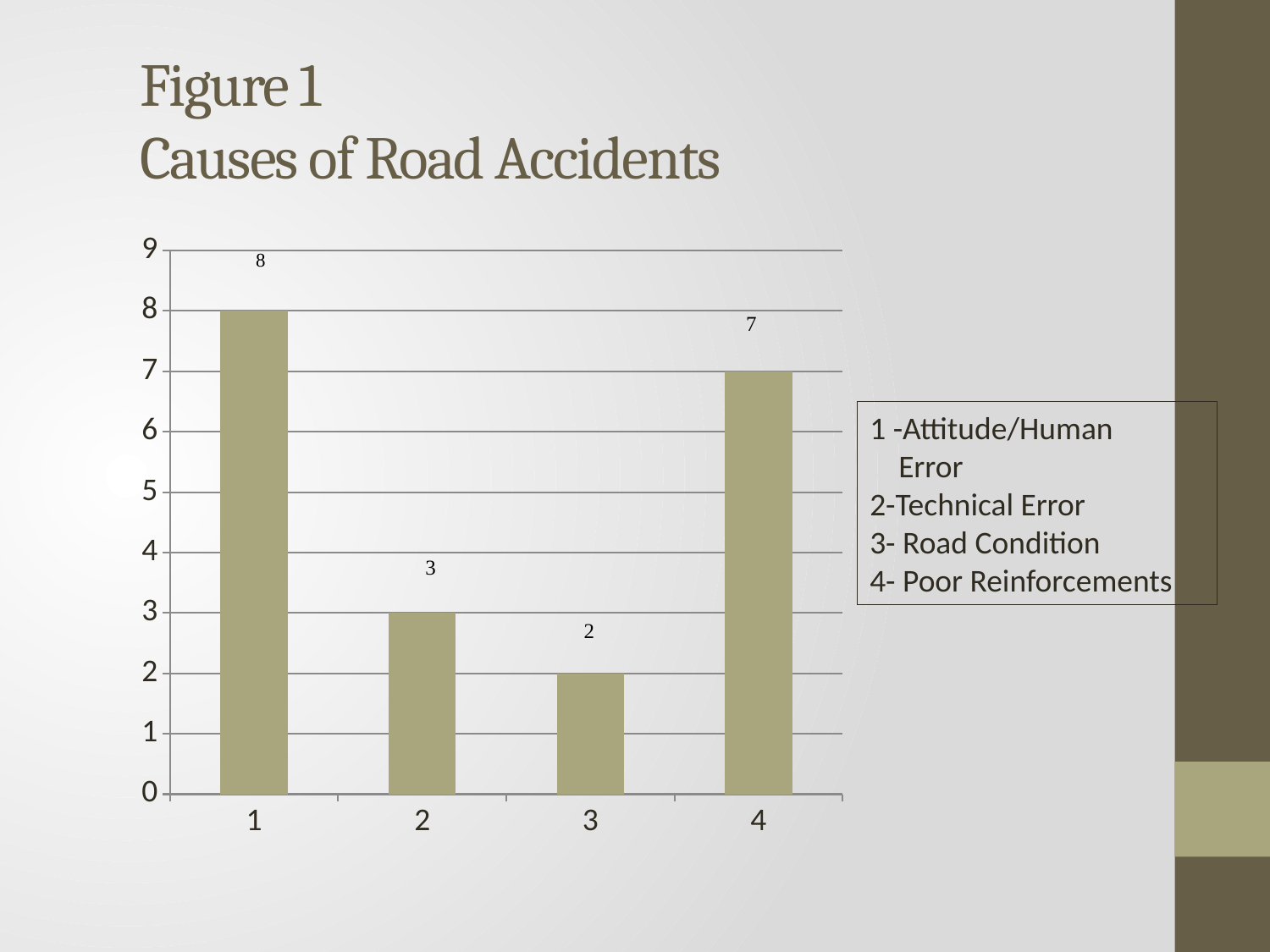
What is the difference between the values for category 1 and category 4? 1 What is the value for category 2 (Technical Error)? 3 Which category has the highest value? 1 (Attitude/Human Error) What is the value for category 1 (Attitude/Human Error)? 8 Which category has the lowest value? 3 (Road Condition) What is the value for category 3 (Road Condition)? 2 How many categories are shown on the x axis? 4 Which is larger, the value for category 2 or the value for category 4? Category 4 What is the title of the figure on the slide? Figure 1 Causes of Road Accidents What is the difference between the values for category 2 and category 3? 1 What is the value for category 4 (Poor Reinforcements)? 7 What kind of chart is shown on the slide? Bar chart